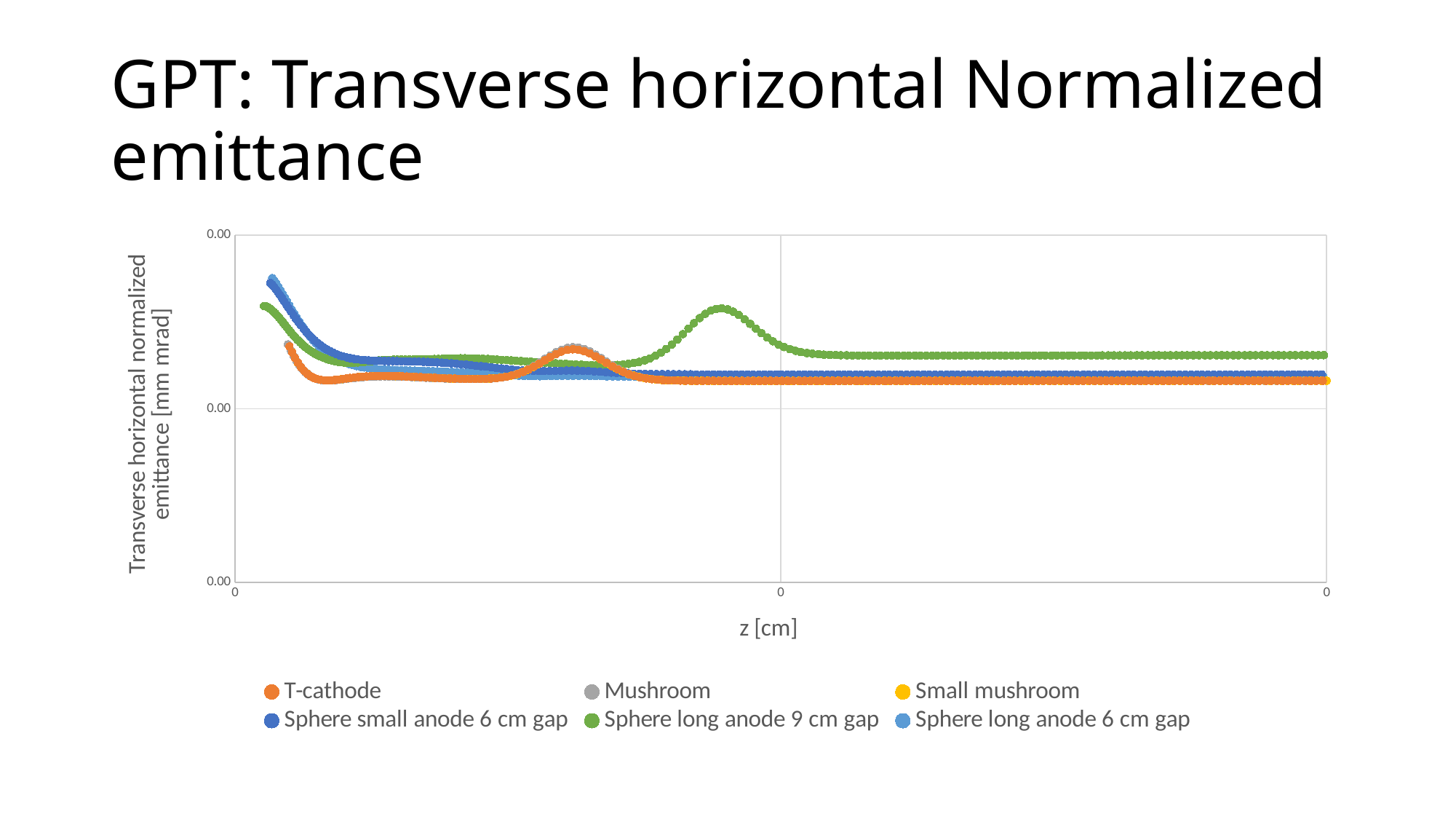
Which series has the highest value at the right-hand end of the x axis? Sphere long anode 9 cm gap Does the Sphere long anode 6 cm gap series rise or fall over the first part of the x axis? fall At the right-hand end of the x axis, is the value for T-cathode larger or smaller than the value for Sphere long anode 9 cm gap? smaller What is the label of the x axis? z [cm] What is the label of the y axis? Transverse horizontal normalized emittance [mm mrad] Which series shows a pronounced peak just left of the middle vertical gridline? Sphere long anode 9 cm gap What kind of chart is shown on the slide? Scatter (line) chart Which series is drawn in green? Sphere long anode 9 cm gap How many series does the legend list? 6 At the right-hand end of the x axis, is the value for Sphere long anode 9 cm gap larger or smaller than the value for Sphere small anode 6 cm gap? larger